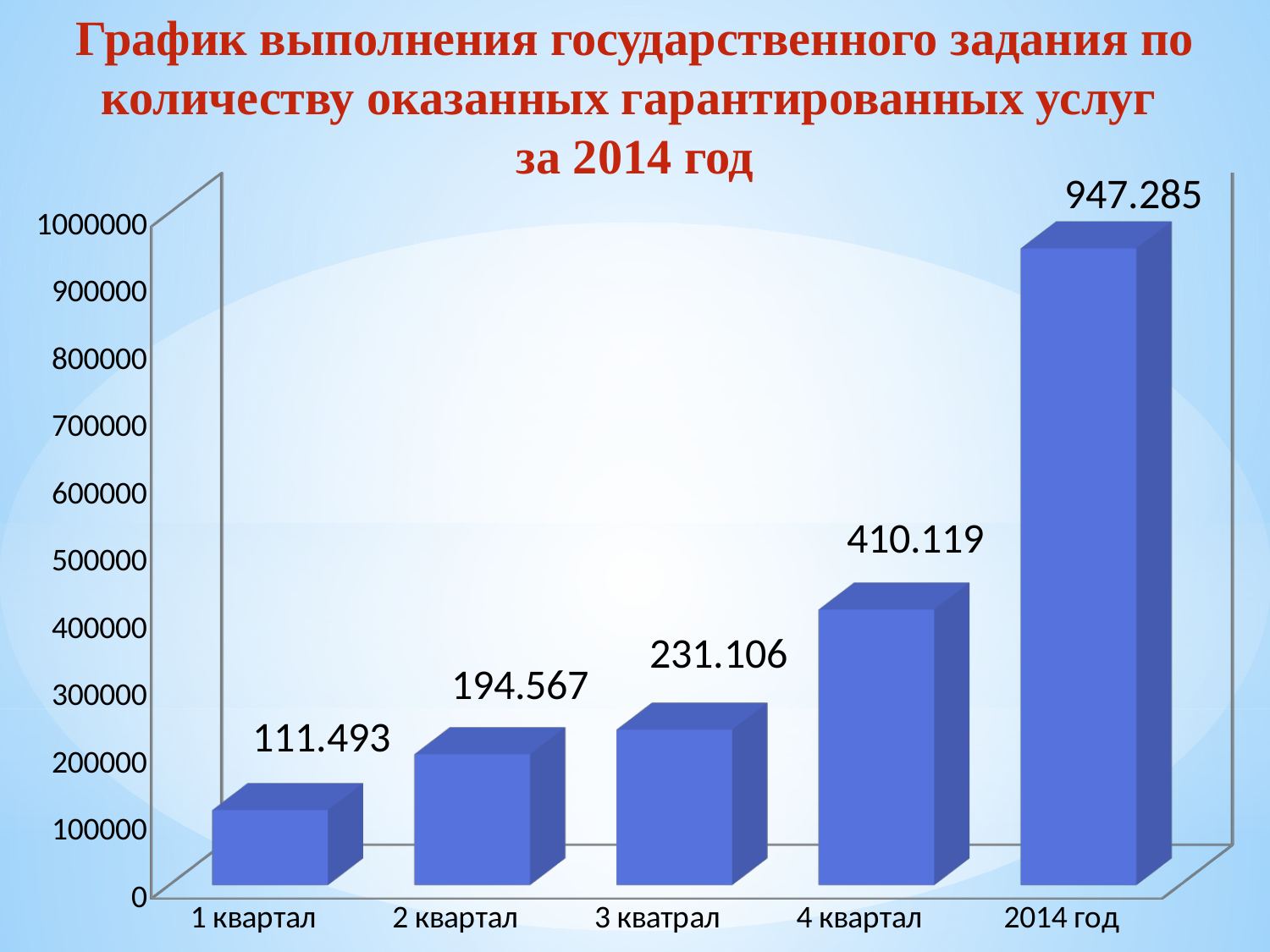
What value is shown for 2014 год? 947.285 How many categories are shown on the x axis? 5 What value is shown for 1 квартал? 111.493 What value is shown for 4 квартал? 410.119 Which category has the highest value? 2014 год Is the value for 1 квартал greater or less than 200000? less What is the difference between the values for 2 квартал and 1 квартал? 83.074 What kind of chart is shown on the slide? bar chart Which category has the lowest value? 1 квартал What is the difference between the values for 2014 год and 4 квартал? 537.166 Which is larger, the value for 3 кватрал or the value for 2 квартал? 3 кватрал What value is shown for 2 квартал? 194.567